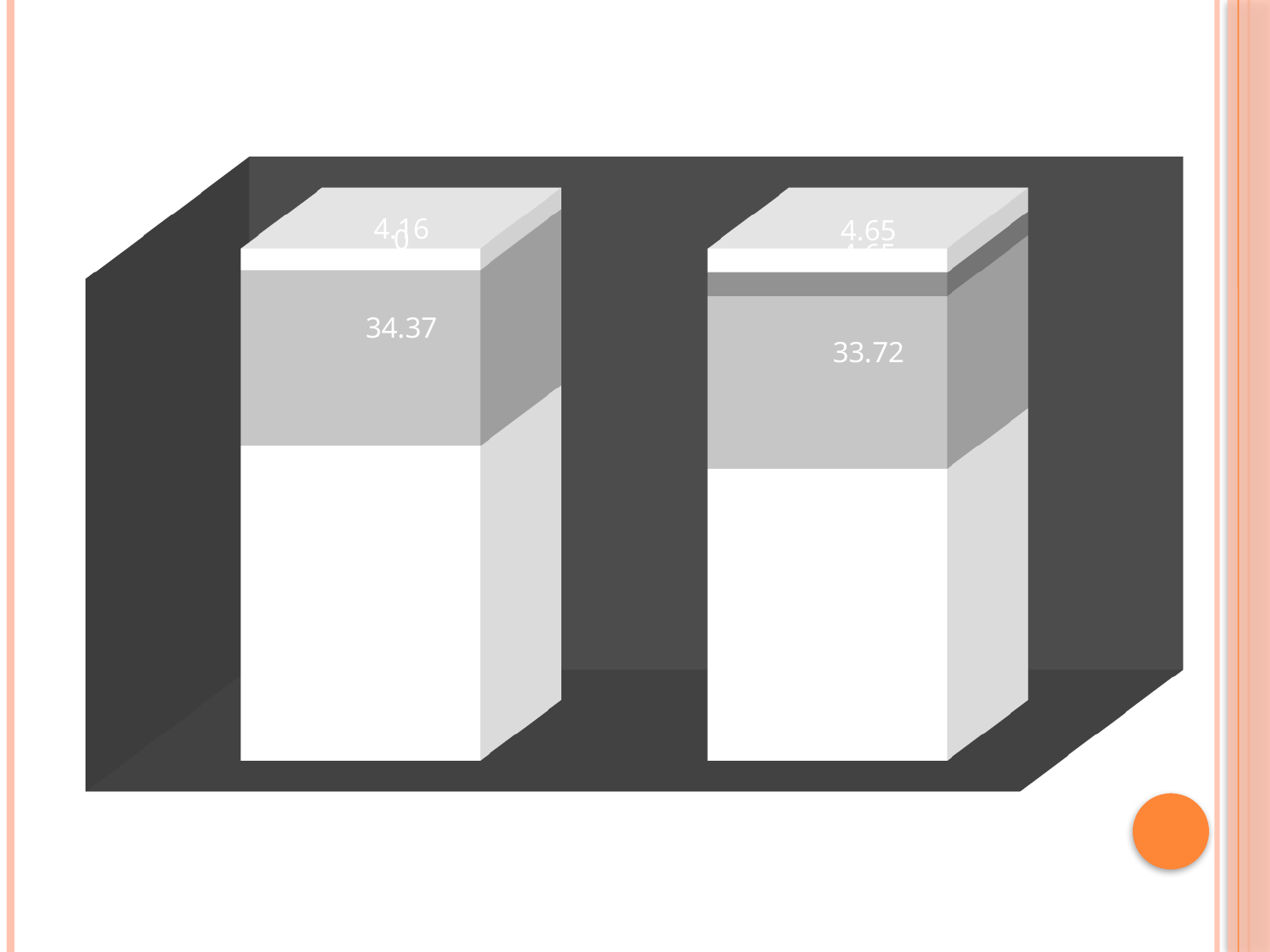
Which bar has the larger grey middle segment value, the left bar (34.37) or the right bar (33.72)? left bar What colour is the chart's background wall behind the bars? dark grey What value is labelled on the grey middle segment of the right bar? 33.72 Does the chart display a legend? No How many bars are plotted in the chart? 2 What is the difference between the top segment values of the right bar (4.65) and the left bar (4.16)? 0.49 What is the difference between the grey middle segment values of the left bar (34.37) and the right bar (33.72)? 0.65 Which bar has the larger top segment value, the left bar (4.16) or the right bar (4.65)? right bar What kind of chart is shown on the slide? bar chart What value is labelled on the grey middle segment of the left bar? 34.37 What value is labelled on the thin top segment of the right bar? 4.65 What value is labelled on the thin top segment of the left bar? 4.16